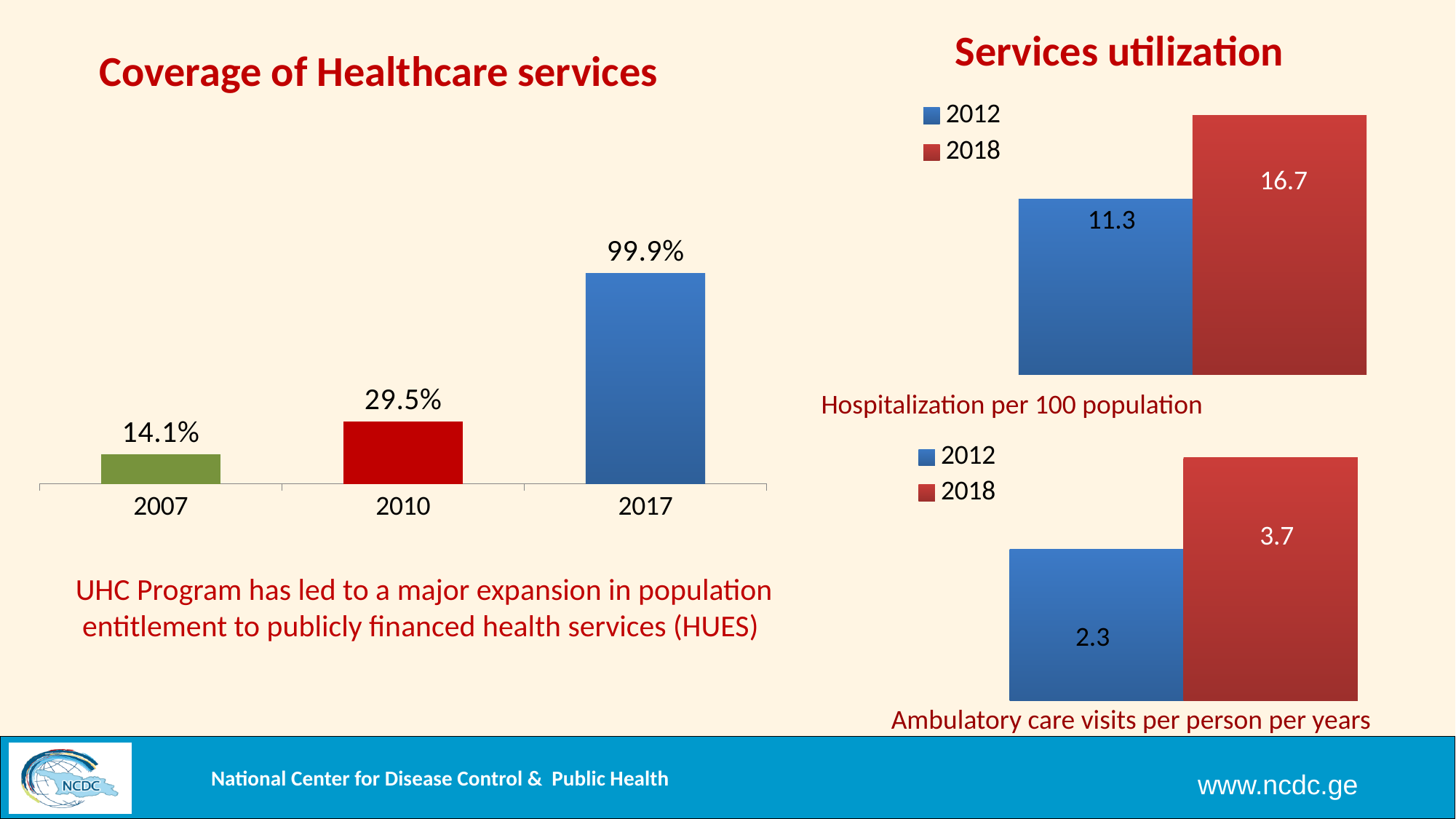
In the 'Ambulatory care visits per person per years' chart, which year has the larger value, 2012 or 2018? 2018 In the 'Hospitalization per 100 population' chart, what is the difference between the 2018 and 2012 values? 5.4 In the 'Coverage of Healthcare services' chart, what is the difference between the 2017 and 2010 values? 70.4% In the 'Hospitalization per 100 population' chart, what is the value for 2018? 16.7 In the 'Coverage of Healthcare services' chart, what is the value for 2017? 99.9% In the 'Ambulatory care visits per person per years' chart, what is the value for 2012? 2.3 In the 'Coverage of Healthcare services' chart, which year has the lowest value? 2007 In the 'Coverage of Healthcare services' chart, do the values rise or fall from 2007 to 2017? rise How many series does the legend of the 'Hospitalization per 100 population' chart list? 2 In the 'Coverage of Healthcare services' chart, what is the value for 2007? 14.1% What kind of chart is the 'Coverage of Healthcare services' chart? bar chart In the 'Coverage of Healthcare services' chart, how many years are shown on the x axis? 3